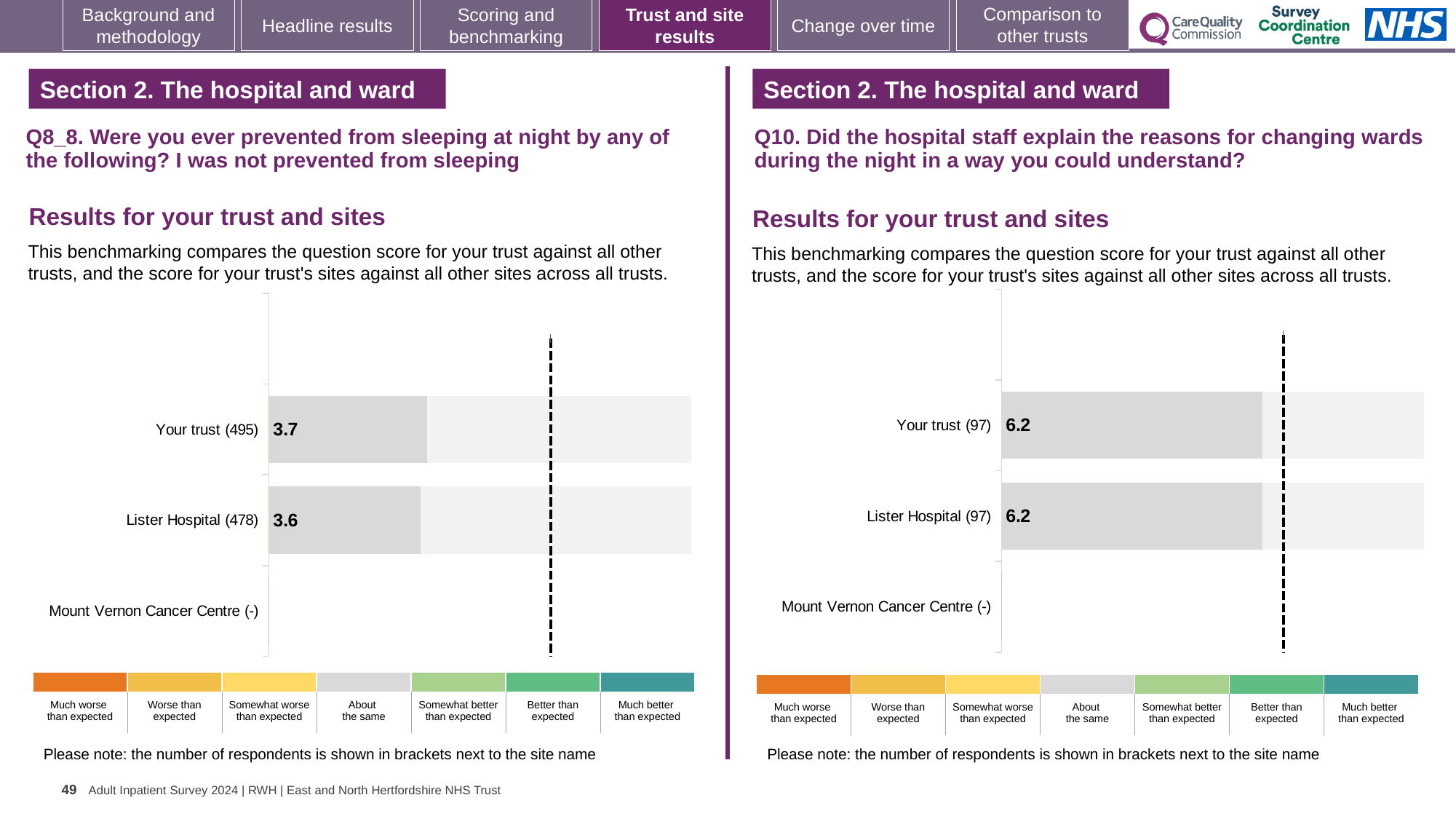
On the left chart (Q8_8), how many site/trust categories are listed on the vertical axis? 3 On the left chart (Q8_8), what is the score for Your trust? 3.7 On the right chart (Q10), how many respondents are shown in brackets for Lister Hospital? 97 On the left chart (Q8_8), how many respondents are shown in brackets for Your trust? 495 On the left chart (Q8_8), what is the difference between the Your trust score and the Lister Hospital score? 0.1 On the right chart (Q10), what is the score for Your trust? 6.2 On the right chart (Q10), which category has no score shown (marked with a dash)? Mount Vernon Cancer Centre What kind of chart is used on the right side of the slide (Q10)? Bar chart On the right chart (Q10), what is the score for Lister Hospital? 6.2 On the left chart (Q8_8), which has the higher score, Your trust or Lister Hospital? Your trust How many rating bands are shown in the colour key beneath the left chart (Q8_8)? 7 On the left chart (Q8_8), what is the score for Lister Hospital? 3.6